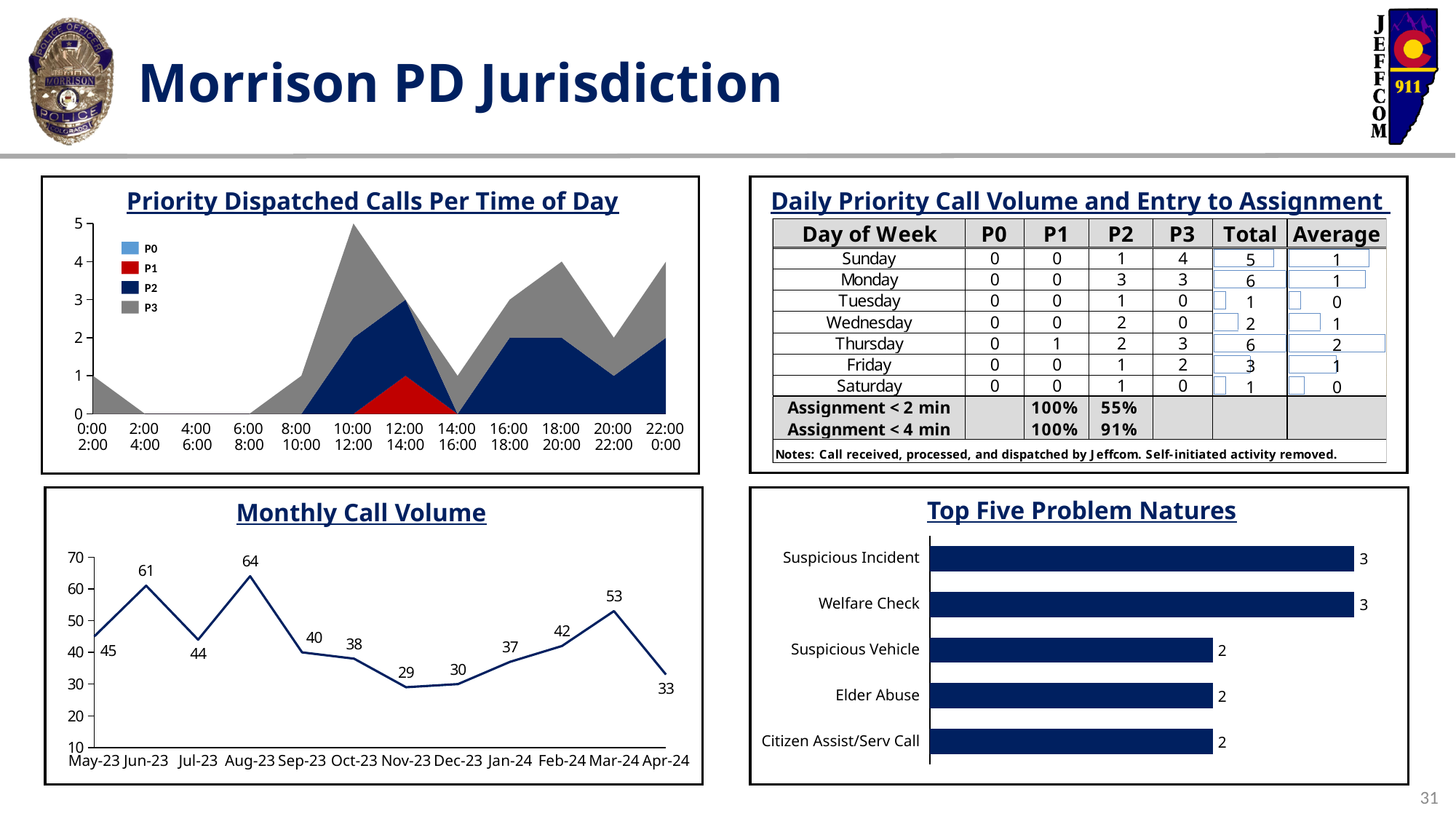
How many months are plotted in the Monthly Call Volume chart? 12 How many categories are shown in the Top Five Problem Natures chart? 5 In the Monthly Call Volume chart, what is the value for Aug-23? 64 How many series does the legend of the Priority Dispatched Calls Per Time of Day chart list? 4 In the Monthly Call Volume chart, which month has the lowest call volume? Nov-23 In the Monthly Call Volume chart, which is larger, the value for Jun-23 or the value for Jul-23? Jun-23 In the Monthly Call Volume chart, what is the difference between the values for Mar-24 and Apr-24? 20 In the Top Five Problem Natures chart, what is the value for Suspicious Vehicle? 2 In the Monthly Call Volume chart, which month has the highest call volume? Aug-23 In the Priority Dispatched Calls Per Time of Day chart, is the total value for the 10:00-12:00 period greater or less than 4? greater What kind of chart is the Top Five Problem Natures chart? Bar chart What kind of chart is the Monthly Call Volume chart? Line chart